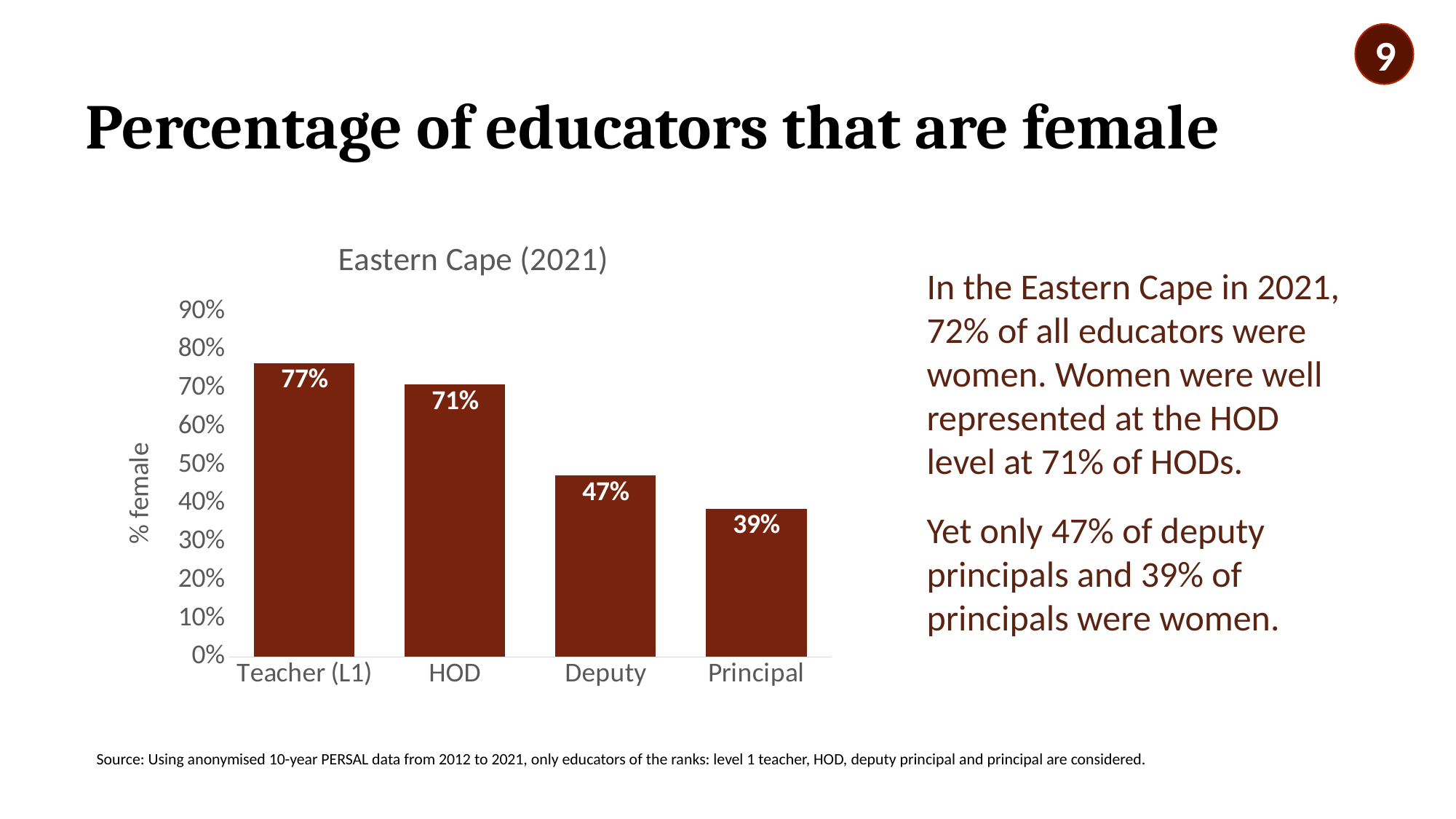
What percentage of Teacher (L1) educators are female in the Eastern Cape (2021) chart? 77% What is the difference between the Teacher (L1) and Principal values? 38% What is the difference between the HOD and Deputy values? 24% How many categories are shown on the x axis of the chart? 4 Which category has the lowest percentage of female educators? Principal What is the value shown for Principal in the chart? 39% What is the value shown for Deputy in the chart? 47% What is the value shown for HOD in the chart? 71% Which category has the highest percentage of female educators? Teacher (L1) What kind of chart is shown on the slide? Bar chart Which is larger, the value for Deputy or the value for Principal? Deputy Do the values rise or fall moving from Teacher (L1) to Principal along the x axis? Fall